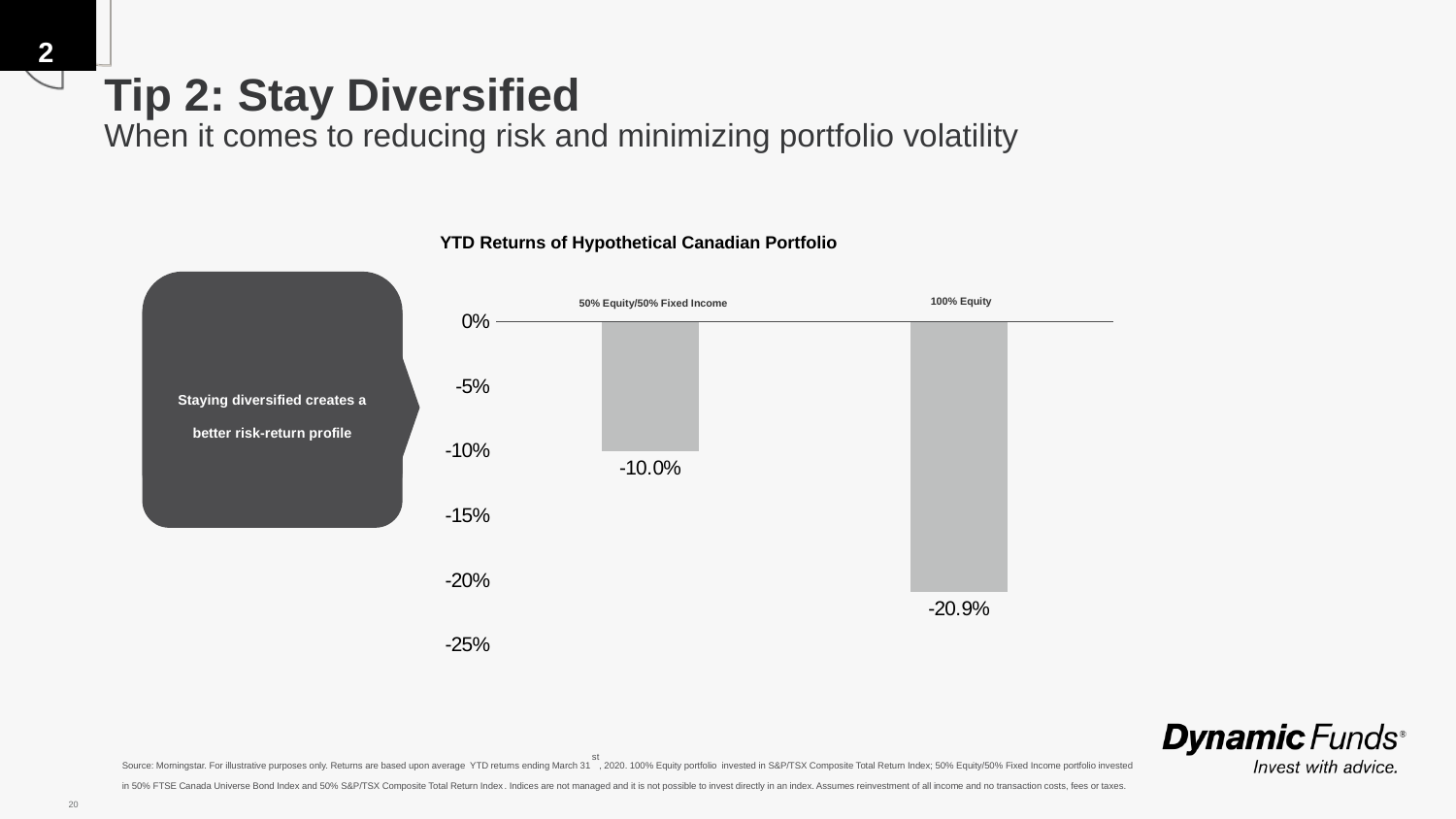
What is the YTD return shown for the 100% Equity portfolio? -20.9% Which portfolio has the highest YTD return? 50% Equity/50% Fixed Income What is the difference between the YTD returns of the 100% Equity portfolio and the 50% Equity/50% Fixed Income portfolio? 10.9 percentage points What kind of chart is shown on the slide? Bar chart How many portfolios are plotted in the chart? 2 Is the YTD return for the 100% Equity portfolio greater or less than -20%? less Is the YTD return for the 50% Equity/50% Fixed Income portfolio greater or less than -15%? greater Which portfolio lost more year-to-date, 100% Equity or 50% Equity/50% Fixed Income? 100% Equity What is the YTD return shown for the 50% Equity/50% Fixed Income portfolio? -10.0% What is the title of the chart? YTD Returns of Hypothetical Canadian Portfolio What is the lowest value shown on the chart's vertical axis? -25% Which portfolio has the lowest (most negative) YTD return? 100% Equity